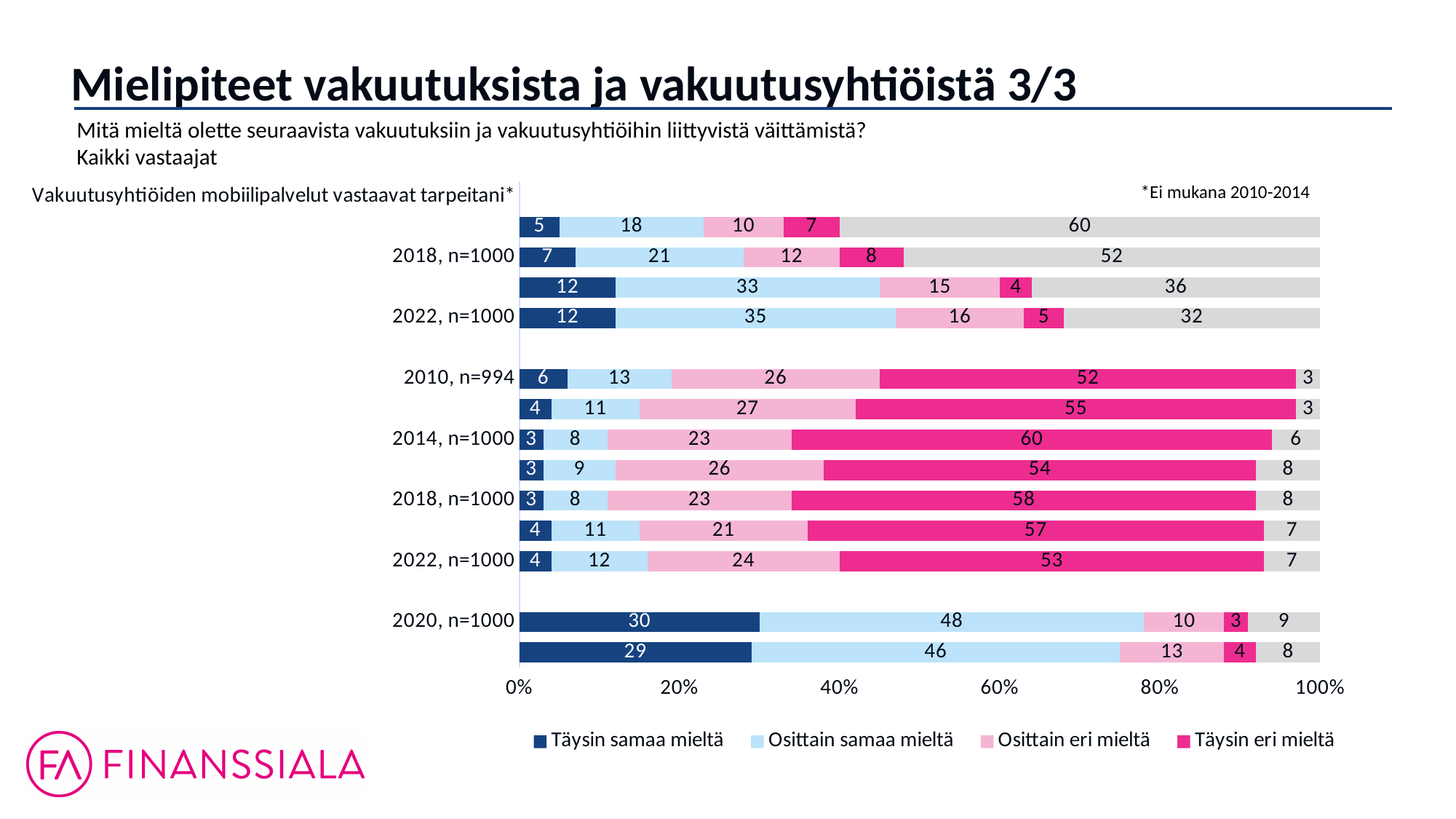
What kind of chart is shown on the slide? Stacked bar chart In the top group (Vakuutusyhtiöiden mobiilipalvelut vastaavat tarpeitani), what is the value of Täysin samaa mieltä for the bar labelled 2018, n=1000? 7 What does the footnote at the top right of the chart say? *Ei mukana 2010-2014 For the bar labelled 2020, n=1000, how much larger is Osittain samaa mieltä than Täysin samaa mieltä? 18 What is the value of Täysin eri mieltä for the bar labelled 2010, n=994? 52 What is the value of Täysin samaa mieltä for the bar labelled 2020, n=1000? 30 For the bar labelled 2020, n=1000, what is the total of the four legend categories (Täysin samaa mieltä, Osittain samaa mieltä, Osittain eri mieltä, Täysin eri mieltä)? 91 Which bar has the larger Täysin eri mieltä value: 2010, n=994 or 2014, n=1000? 2014, n=1000 In the top group (Vakuutusyhtiöiden mobiilipalvelut vastaavat tarpeitani), what is the value of Osittain samaa mieltä for the bar labelled 2022, n=1000? 35 What is the value of Osittain samaa mieltä for the bar labelled 2020, n=1000? 48 How many series does the legend list? 4 What is the value of Täysin eri mieltä for the bar labelled 2014, n=1000? 60